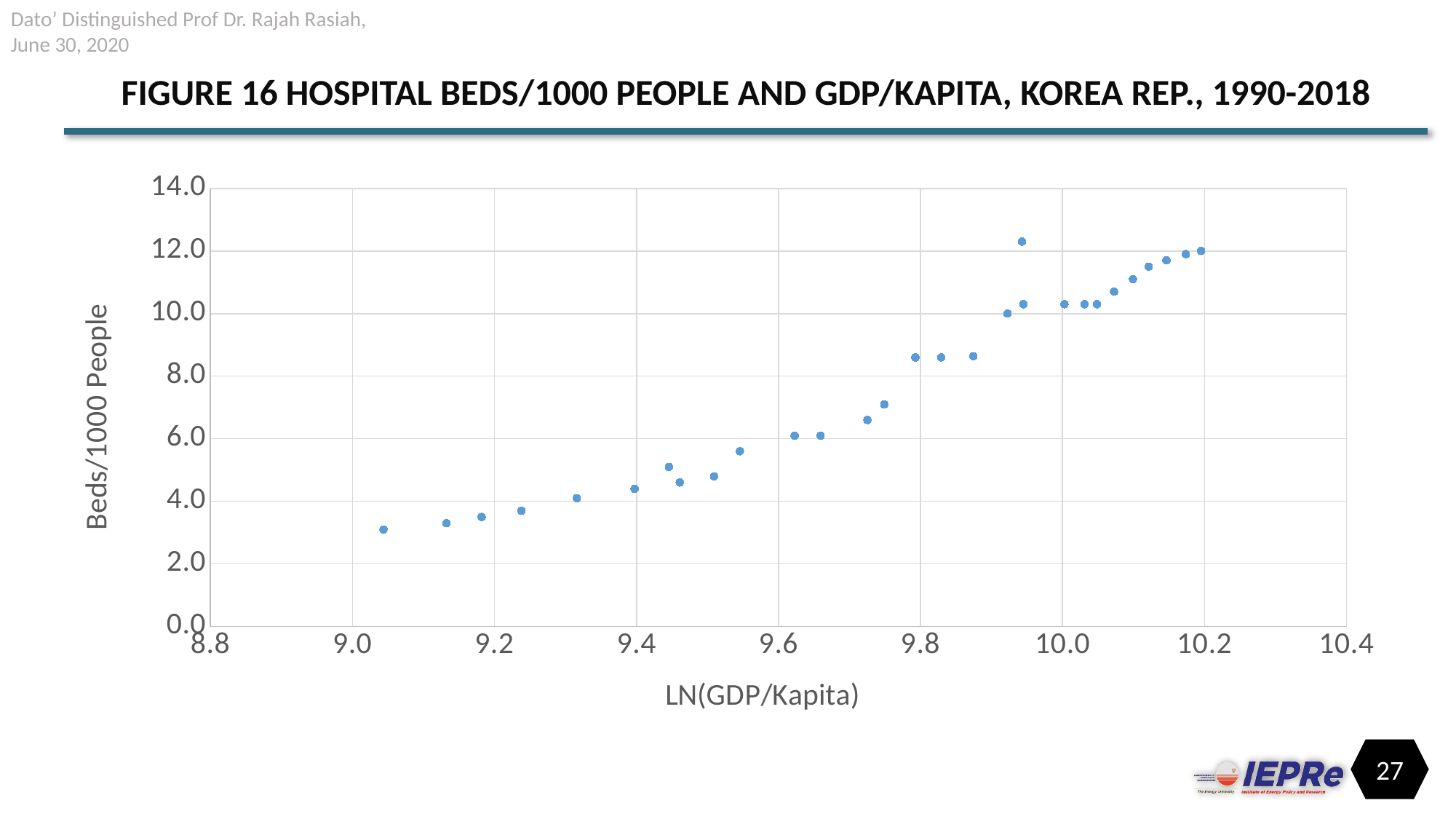
Are any points on the chart above 14.0 beds per 1000 people? No Which has more beds per 1000 people: the leftmost point or the rightmost point on the chart? The rightmost point What kind of chart is shown on the slide? Scatter plot Is the lowest point on the chart greater or less than 4.0 beds per 1000 people? less Is the rightmost point on the chart (at the highest LN(GDP/Kapita)) greater or less than 10.0 beds per 1000 people? greater Do the values of Beds/1000 People generally rise or fall as LN(GDP/Kapita) increases? Rise What is the title of the chart? FIGURE 16 HOSPITAL BEDS/1000 PEOPLE AND GDP/KAPITA, KOREA REP., 1990-2018 How many data points are plotted on the chart? 29 What is the label of the y axis? Beds/1000 People